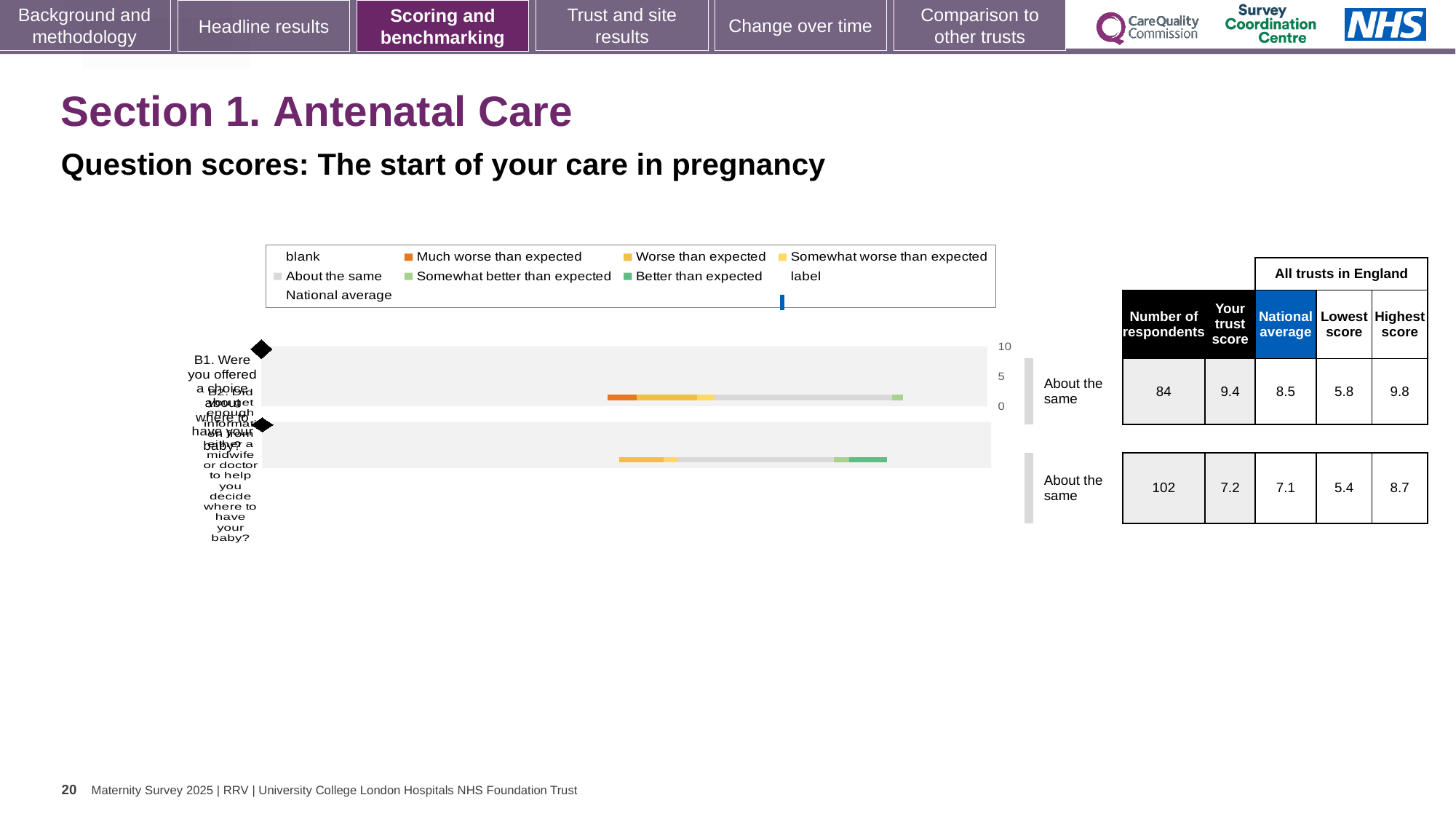
Which question has the higher trust score, B1 or B2? B1 What is the national average for question B1? 8.5 According to the legend, what does the blue marker on the chart represent? National average How many entries does the chart legend list? 9 What is the highest score across all trusts in England for question B1? 9.8 What is the 'Your trust score' for question B1 (Were you offered a choice about where to have your baby?)? 9.4 By how much does the trust score for B1 exceed the national average for B1? 0.9 What is the lowest score across all trusts in England for question B2? 5.4 How many respondents answered question B2? 102 What benchmark category is shown for question B1? About the same How many questions (categories) are plotted in the chart? 2 What kind of chart is shown on the slide? bar chart